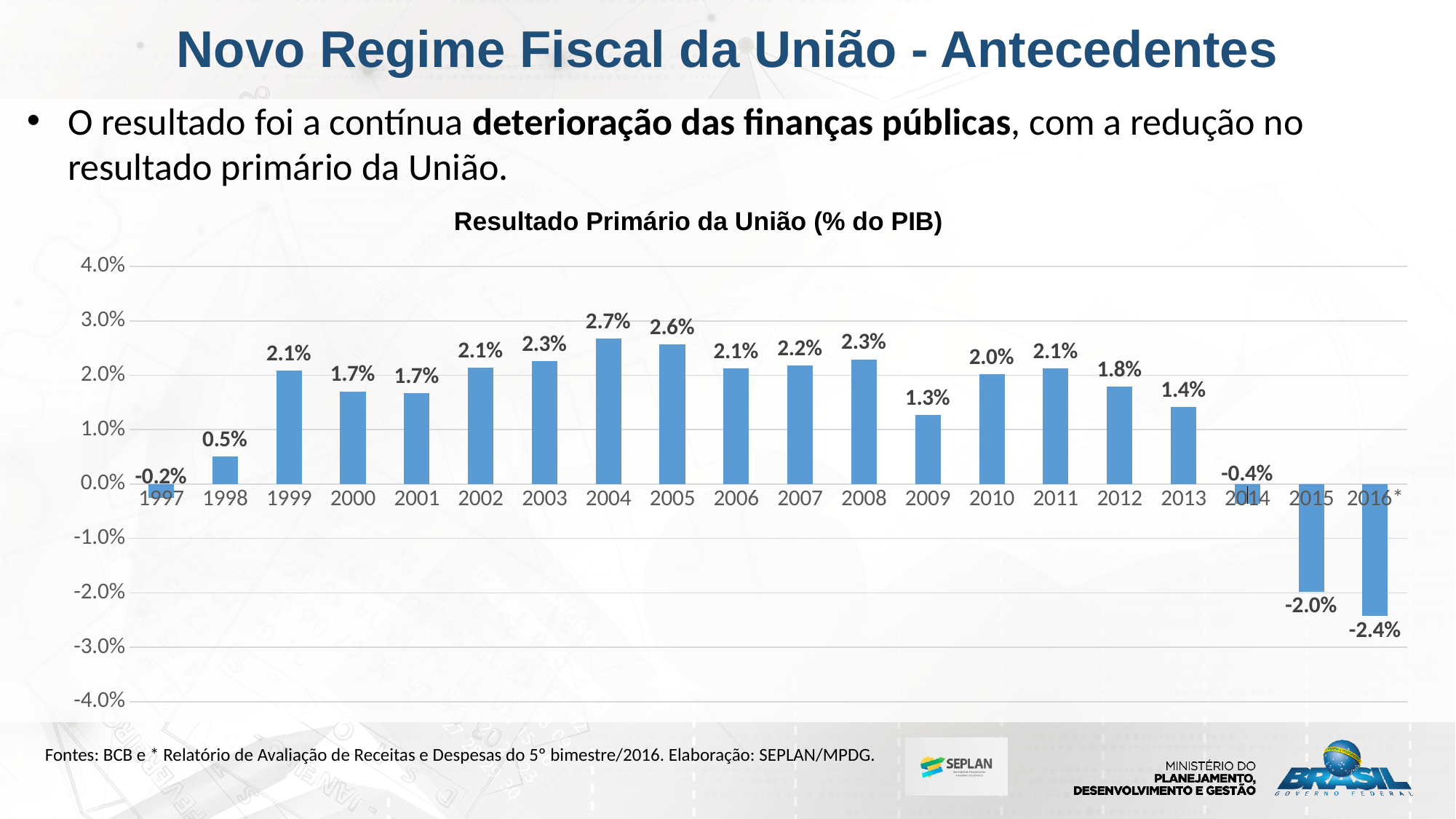
What is the value for 2009 in the chart? 1.3% What kind of chart is shown on the slide? Bar chart What is the difference between the values for 2004 and 2009? 1.4% How many years are shown on the x axis of the chart? 20 Do the values rise or fall from 2013 to 2016*? Fall Which year has the lowest value in the chart? 2016* What is the title of the chart? Resultado Primário da União (% do PIB) Which is larger, the value for 2012 or the value for 2013? 2012 Is the value for 2005 greater or less than 2.0%? greater What is the value for 2016* in the chart? -2.4% What is the value for 2004 in the chart? 2.7% Which year has the highest value in the chart? 2004